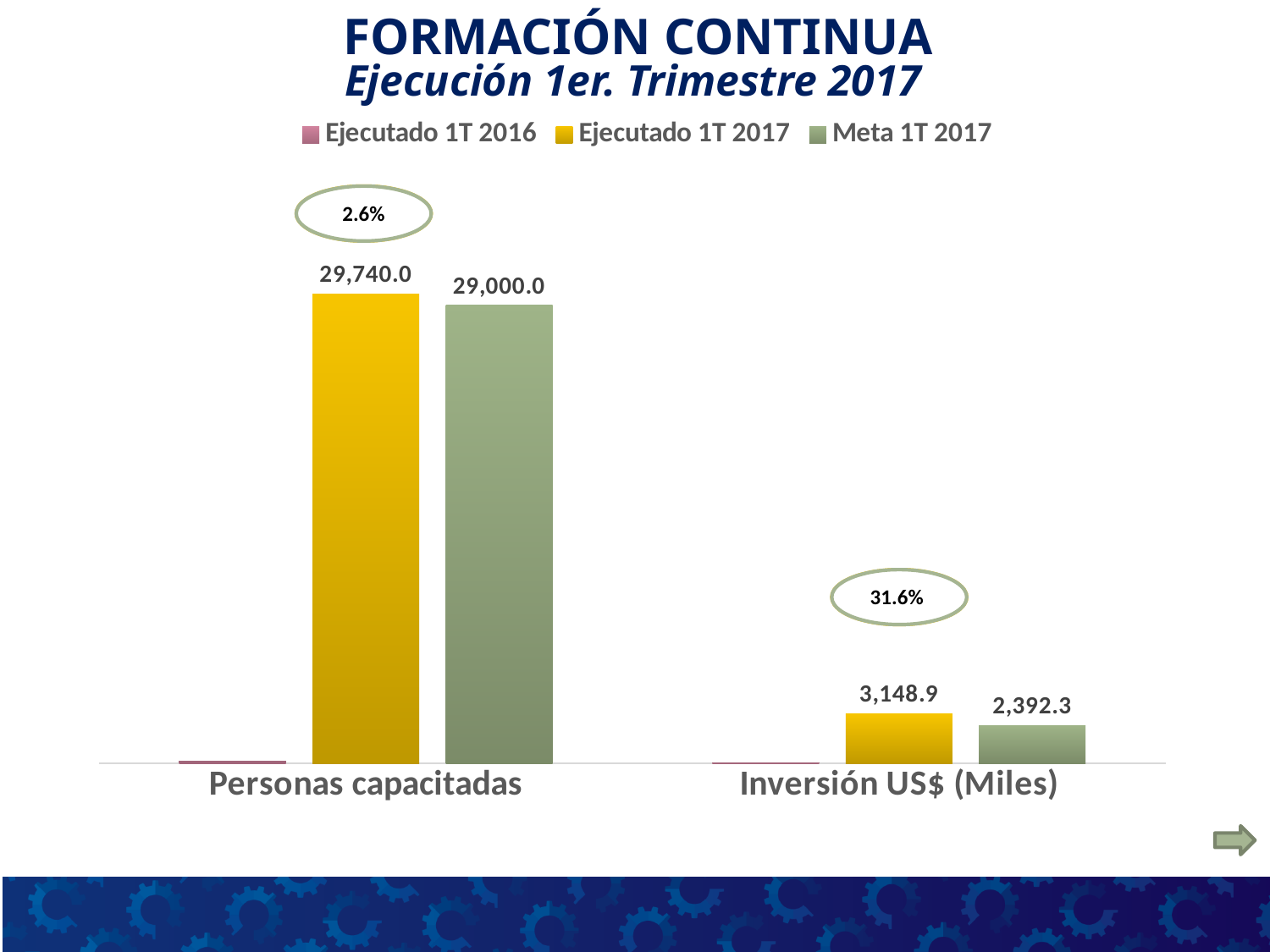
What kind of chart is shown on the slide? Bar chart For Inversión US$ (Miles), which is larger: Ejecutado 1T 2017 or Meta 1T 2017? Ejecutado 1T 2017 What percentage is shown in the oval above the Inversión US$ (Miles) bars? 31.6% How many series does the legend list? 3 What is the Ejecutado 1T 2017 value for Inversión US$ (Miles)? 3,148.9 What percentage is shown in the oval above the Personas capacitadas bars? 2.6% How many categories are shown on the x axis? 2 What is the difference between Ejecutado 1T 2017 and Meta 1T 2017 for Personas capacitadas? 740.0 What is the Meta 1T 2017 value for Personas capacitadas? 29,000.0 What is the Ejecutado 1T 2017 value for Personas capacitadas? 29,740.0 What is the difference between Ejecutado 1T 2017 and Meta 1T 2017 for Inversión US$ (Miles)? 756.6 What is the Meta 1T 2017 value for Inversión US$ (Miles)? 2,392.3